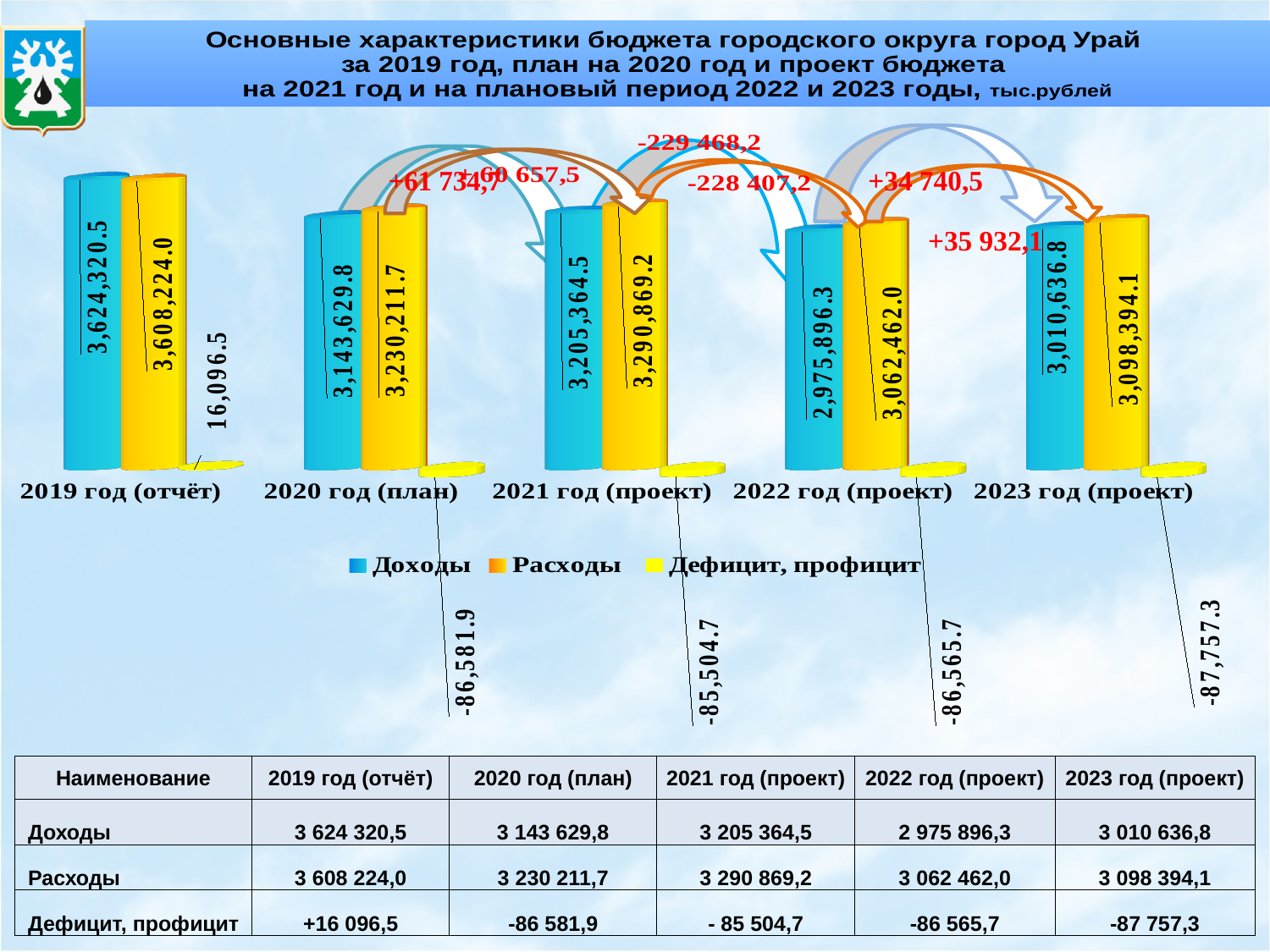
Which year has the lowest value of Доходы? 2022 год (проект) How many series does the chart legend list? 3 What is the value of Дефицит, профицит for 2023 год (проект)? -87,757.3 How many year categories are shown on the x axis of the chart? 5 What is the value of Доходы for 2019 год (отчёт)? 3,624,320.5 What is the value of Расходы for 2022 год (проект)? 3,062,462.0 What is the value of Расходы for 2021 год (проект)? 3,290,869.2 Which year has the highest value of Доходы? 2019 год (отчёт) Which year has the highest value of Расходы? 2019 год (отчёт) What kind of chart is shown on the slide? Bar chart By how much do Расходы exceed Доходы in 2020 год (план)? 86,581.9 In 2021 год (проект), which is larger: Доходы or Расходы? Расходы